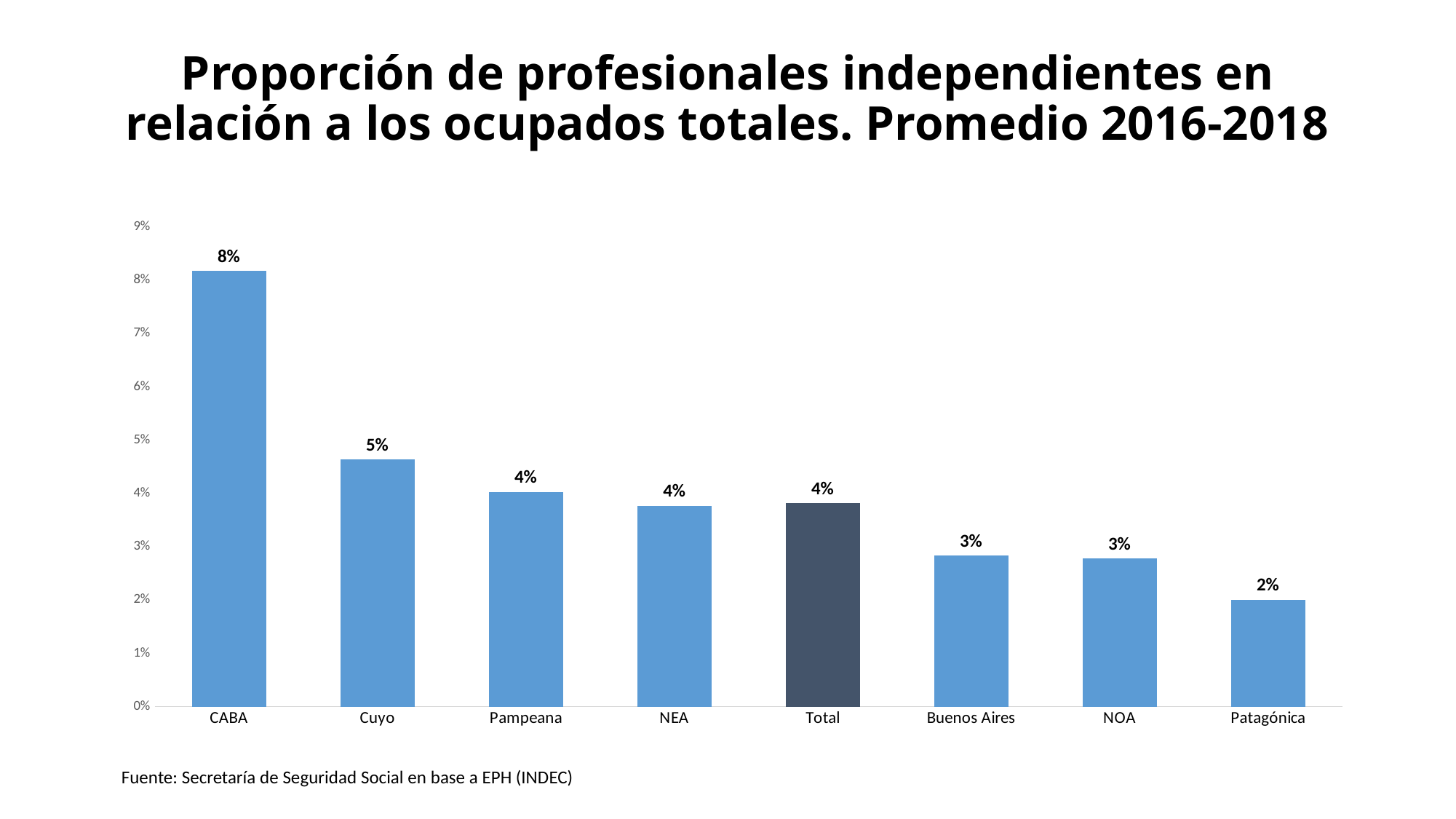
Do the values rise or fall from left to right along the x axis? Fall How many categories are shown on the x axis? 8 What type of chart is shown on the slide? Bar chart What is the value for Patagónica? 2% Is the value for CABA greater or less than 7%? greater What is the value for Cuyo? 5% Which is larger, the value for CABA or the value for Cuyo? CABA Which bar is shown in a darker colour than the others? Total Which category has the highest value? CABA What is the value for CABA? 8% What is the value for Total? 4% Which category has the lowest value? Patagónica